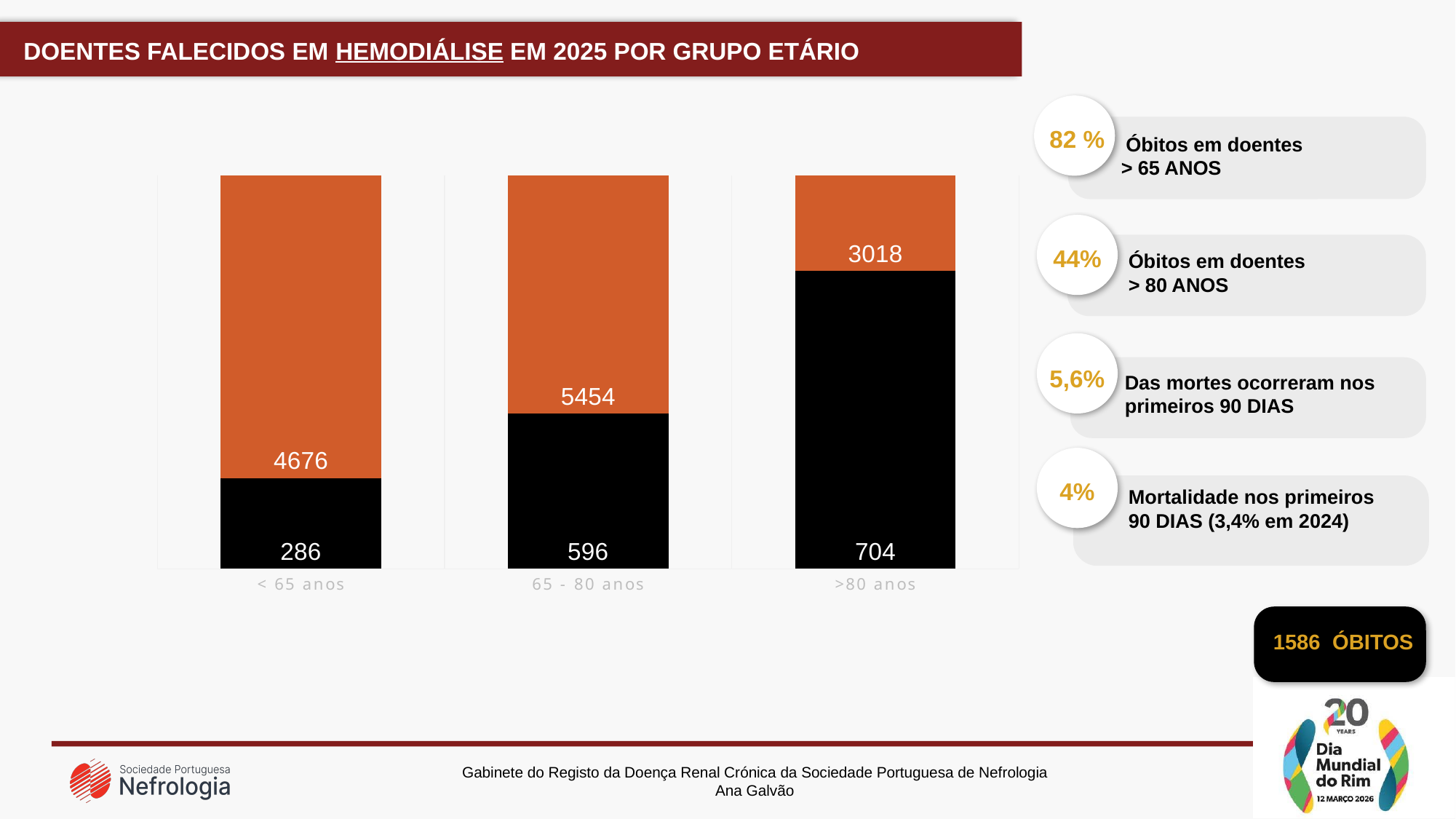
How many age groups are shown on the x axis of the chart? 3 Which is larger: the orange segment value for '65 - 80 anos' or for '< 65 anos'? 65 - 80 anos What is the difference between the black segment values for '>80 anos' and '< 65 anos'? 418 What is the value printed on the orange segment of the bar for '< 65 anos'? 4676 What is the sum of the two values printed on the bar for '65 - 80 anos'? 6050 What is the value printed on the black segment of the bar for '>80 anos'? 704 What is the value printed on the black segment of the bar for '65 - 80 anos'? 596 Which age group has the highest value in the black segment? >80 anos What kind of chart is shown on the slide? Stacked bar chart Which age group has the lowest value in the orange segment? >80 anos Do the black segment values rise or fall from '< 65 anos' to '>80 anos'? Rise What is the value printed on the orange segment of the bar for '>80 anos'? 3018